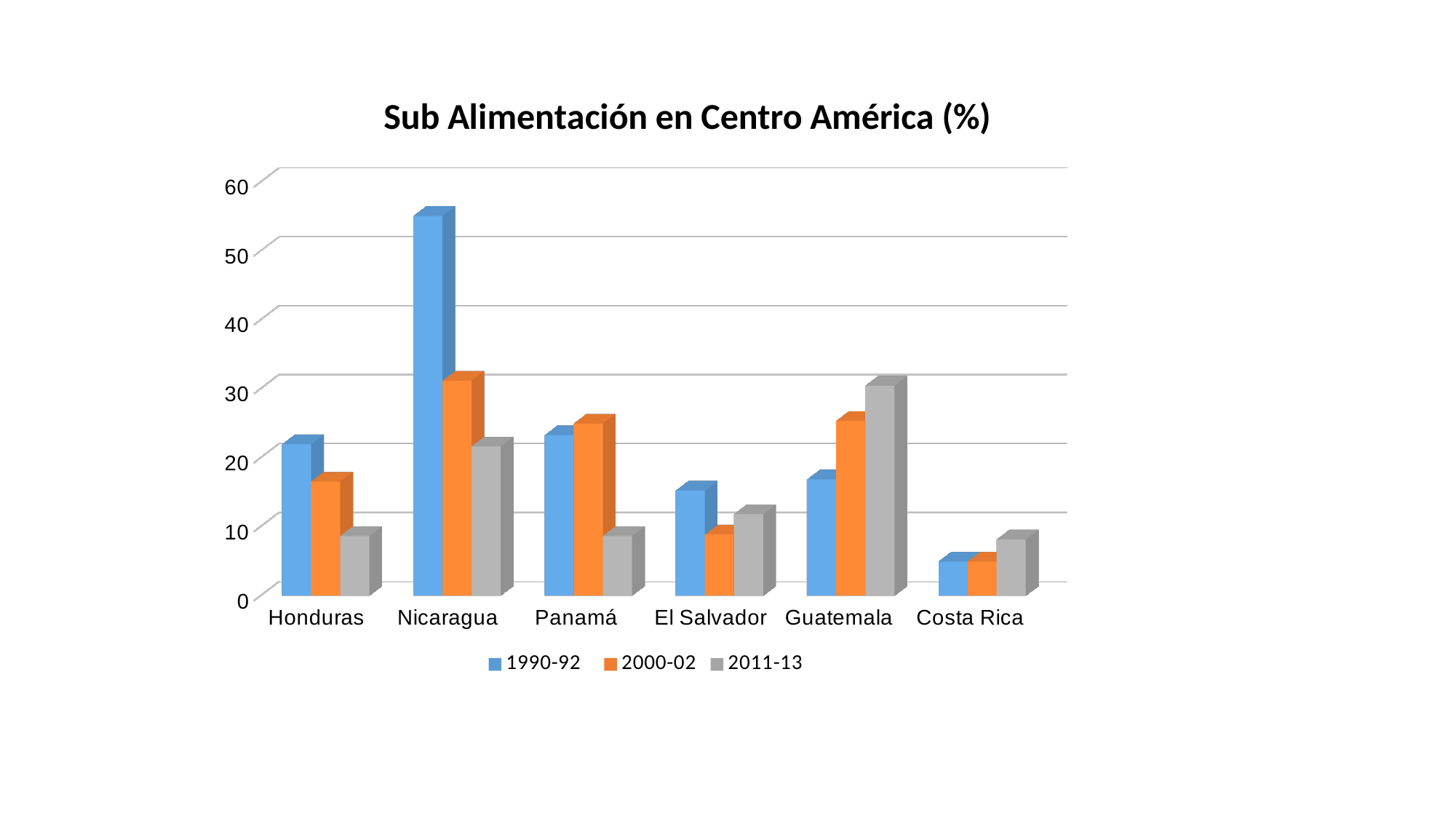
For Honduras, do the values rise or fall from 1990-92 to 2011-13? fall Which country has the highest value for the 2011-13 series? Guatemala Is the 1990-92 value for Nicaragua greater or less than 50? greater Which country has the highest value for the 1990-92 series? Nicaragua Which country has the lowest value for the 1990-92 series? Costa Rica What is the title of the chart? Sub Alimentación en Centro América (%) Is the 2011-13 value for Honduras greater or less than 10? less For Guatemala, which series has the larger value: 1990-92 or 2011-13? 2011-13 How many countries are shown on the x axis of the chart? 6 How many series does the legend list? 3 For Guatemala, do the values rise or fall from 1990-92 to 2011-13? rise What kind of chart is shown on the slide? bar chart